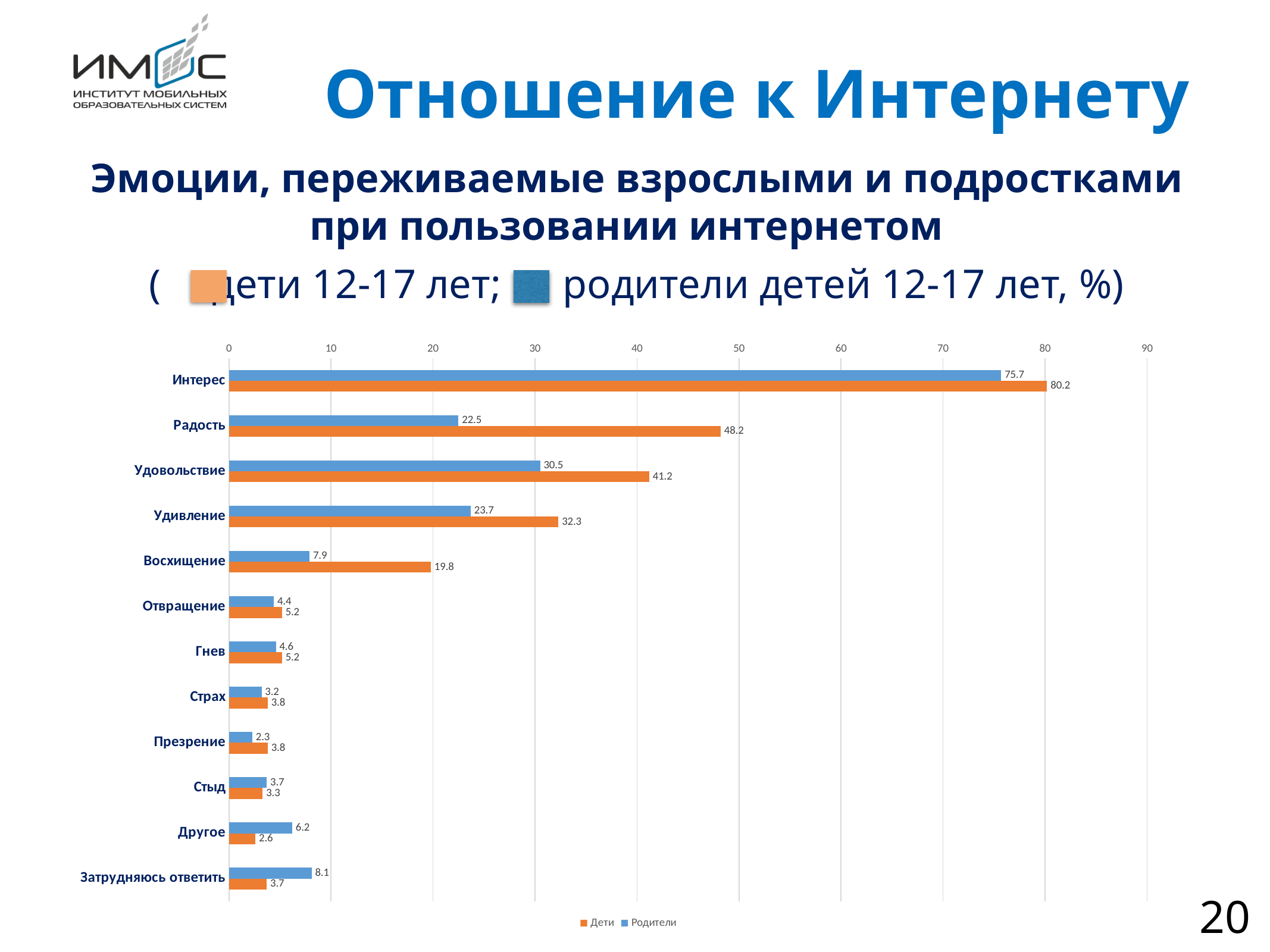
Which colour represents the Дети series? orange Which is larger for Затрудняюсь ответить: the value for Дети or for Родители? Родители What is the value for Родители for Радость? 22.5 How many series does the legend list? 2 What is the value for Дети for Интерес? 80.2 Which category has the highest value for Родители? Интерес What kind of chart is shown on the slide? bar chart Is the value for Дети for Удовольствие greater or less than 40? greater What is the difference between the Дети and Родители values for Радость? 25.7 Which category has the lowest value for Дети? Другое What is the value for Дети for Восхищение? 19.8 How many categories are shown on the chart? 12